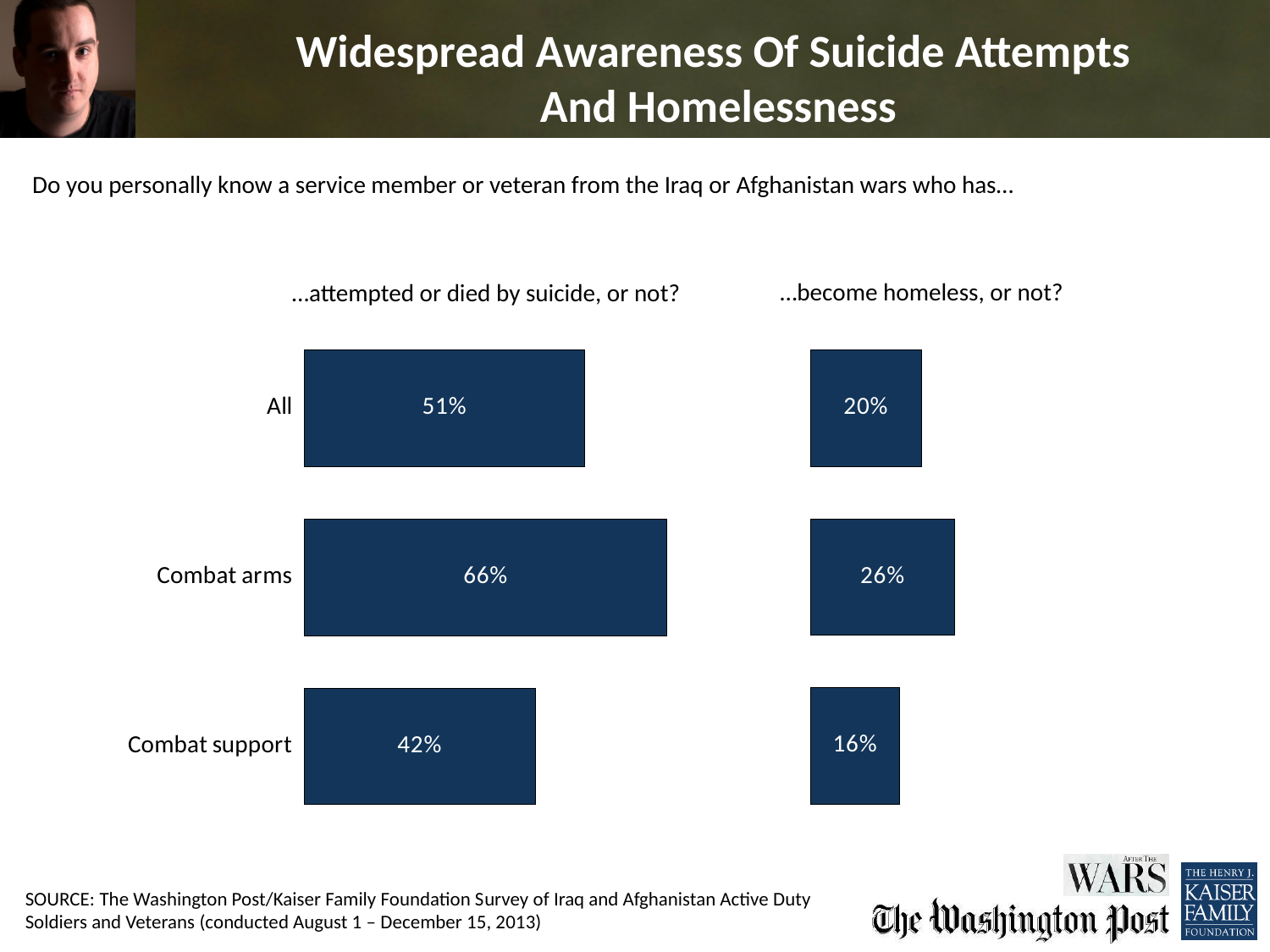
In the chart titled "...attempted or died by suicide, or not?", what is the value for All? 51% In the chart titled "...become homeless, or not?", what is the value for Combat support? 16% In the chart titled "...become homeless, or not?", which is larger, the value for All or the value for Combat support? All In the chart titled "...attempted or died by suicide, or not?", what is the difference between the values for Combat arms and Combat support? 24% In the chart titled "...become homeless, or not?", what is the difference between the values for Combat arms and All? 6% Which is larger, the value for Combat arms in the chart titled "...attempted or died by suicide, or not?" or the value for Combat arms in the chart titled "...become homeless, or not?"? ...attempted or died by suicide, or not? How many categories are shown in the chart titled "...become homeless, or not?"? 3 In the chart titled "...attempted or died by suicide, or not?", which category has the lowest value? Combat support What kind of chart is the chart titled "...attempted or died by suicide, or not?"? Bar chart How many charts are shown on the slide? 2 In the chart titled "...attempted or died by suicide, or not?", what is the value for Combat arms? 66% In the chart titled "...become homeless, or not?", which category has the highest value? Combat arms